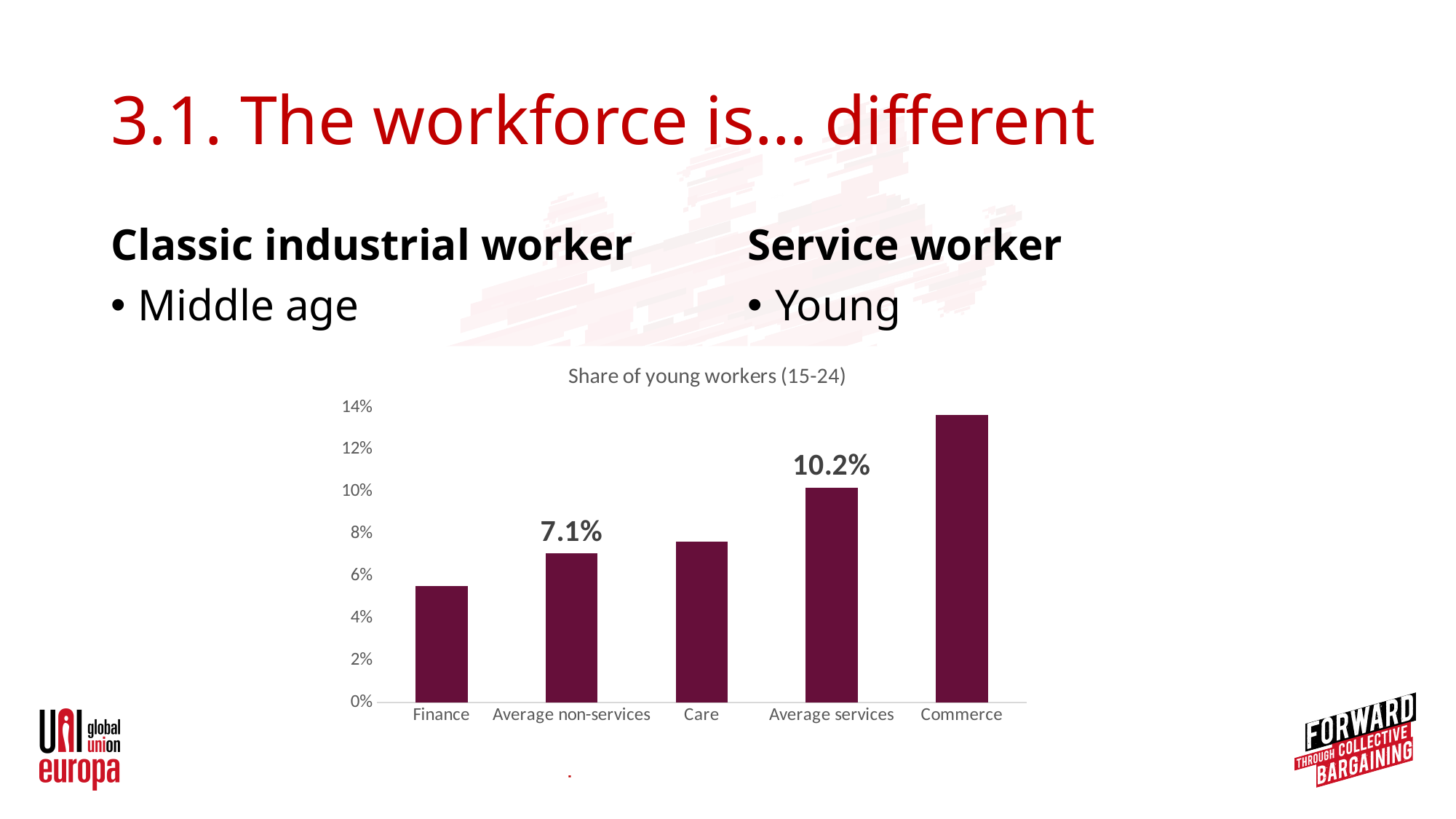
Is the value for Commerce greater or less than 12%? greater Is the value for Care greater or less than 8%? less What is the difference between the values for Average services and Average non-services? 3.1% Which category has the highest share of young workers? Commerce How many categories are shown in the chart? 5 What is the value for Average services in the chart? 10.2% Which category has the lowest share of young workers? Finance What is the title of the chart? Share of young workers (15-24) Is the value for Finance greater or less than 6%? less Which is larger, the value for Care or the value for Commerce? Commerce What is the value for Average non-services in the chart? 7.1% What kind of chart is shown on the slide? Bar chart